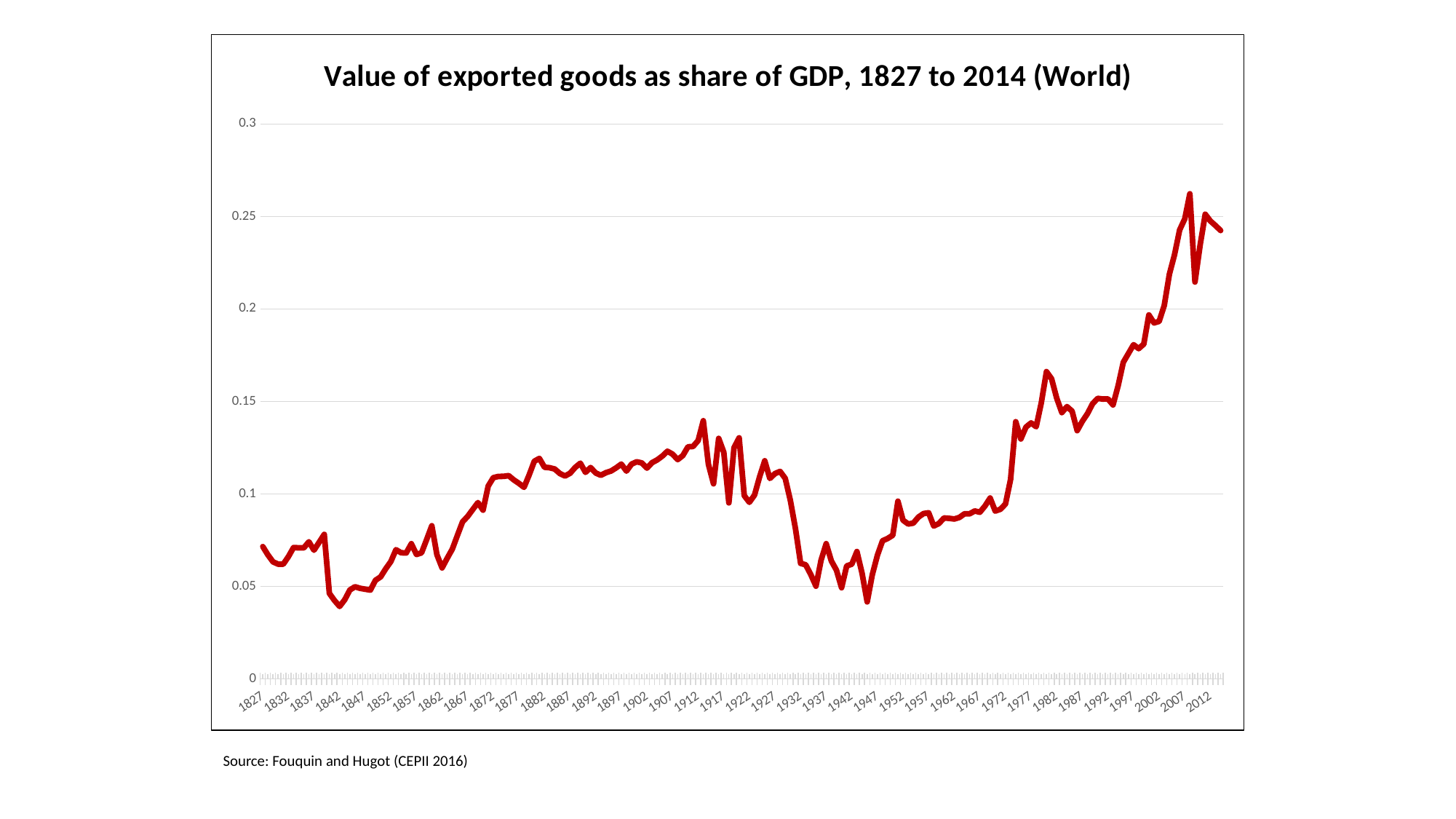
Is the value for 1912 greater or less than 0.1? greater Does the value generally rise or fall between 1912 and 1942? fall Is the value for 1997 greater or less than 0.15? greater Does the value generally rise or fall between 1972 and 2007? rise Which year has the larger value, 1827 or 2007? 2007 Is the value for 1837 greater or less than 0.05? greater What kind of chart is shown on the slide? line chart What is the title of the chart? Value of exported goods as share of GDP, 1827 to 2014 (World) Which year has the larger value, 1912 or 1942? 1912